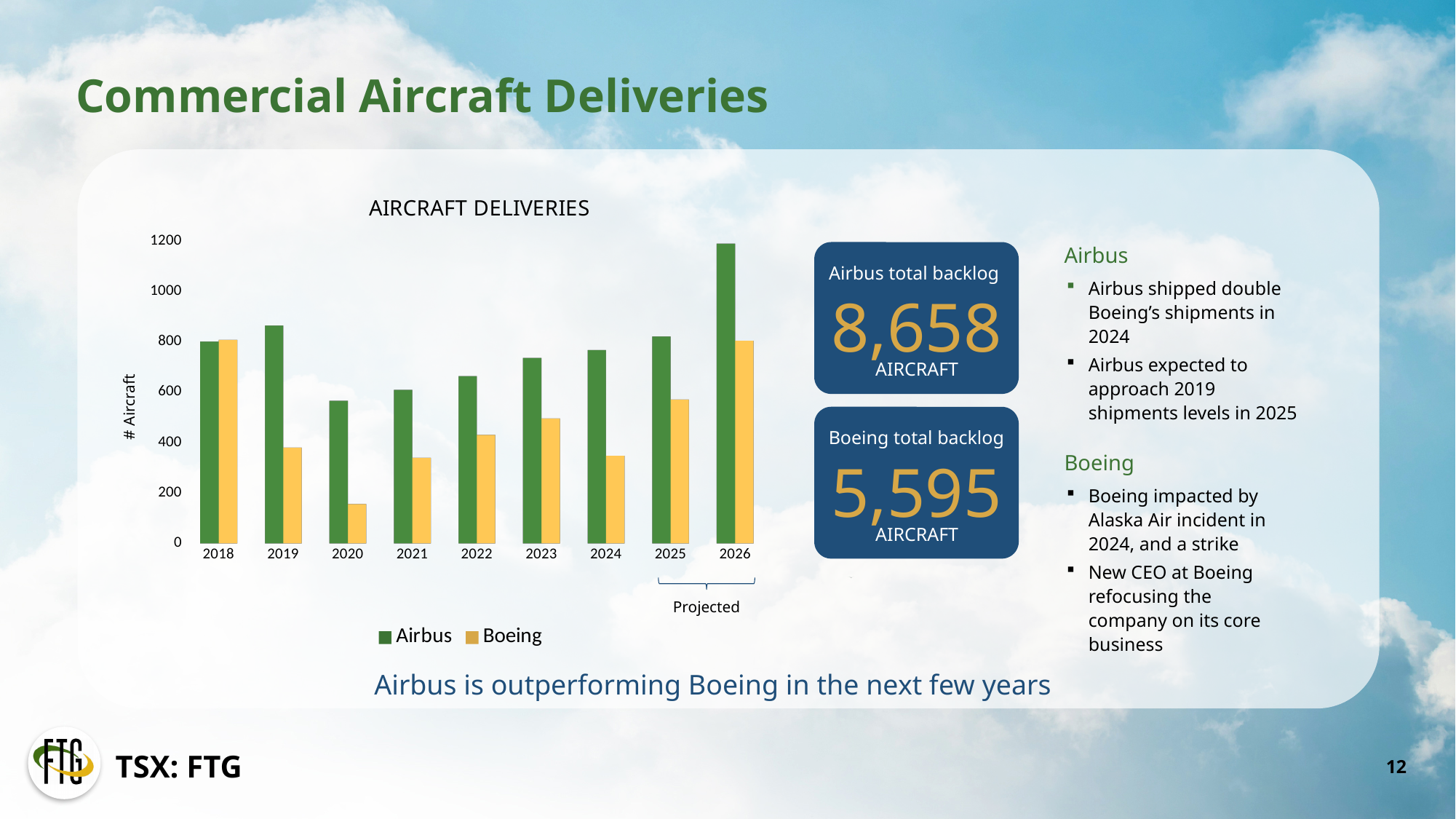
How many years are shown on the x axis of the Aircraft Deliveries chart? 9 Is the value for Airbus in 2026 greater or less than 1000? greater Is the value for Boeing in 2020 greater or less than 200? less In 2024, which is larger: Airbus deliveries or Boeing deliveries? Airbus In which year is the Airbus bar the lowest? 2020 In which year is the Boeing bar the lowest? 2020 What kind of chart is shown on the slide? Bar chart Which years on the chart are marked as projected? 2025 and 2026 How many series does the legend of the Aircraft Deliveries chart list? 2 Is the value for Airbus in 2019 greater or less than 800? greater In which year is the Airbus bar the highest? 2026 Do Boeing deliveries rise or fall from 2020 to 2023? Rise